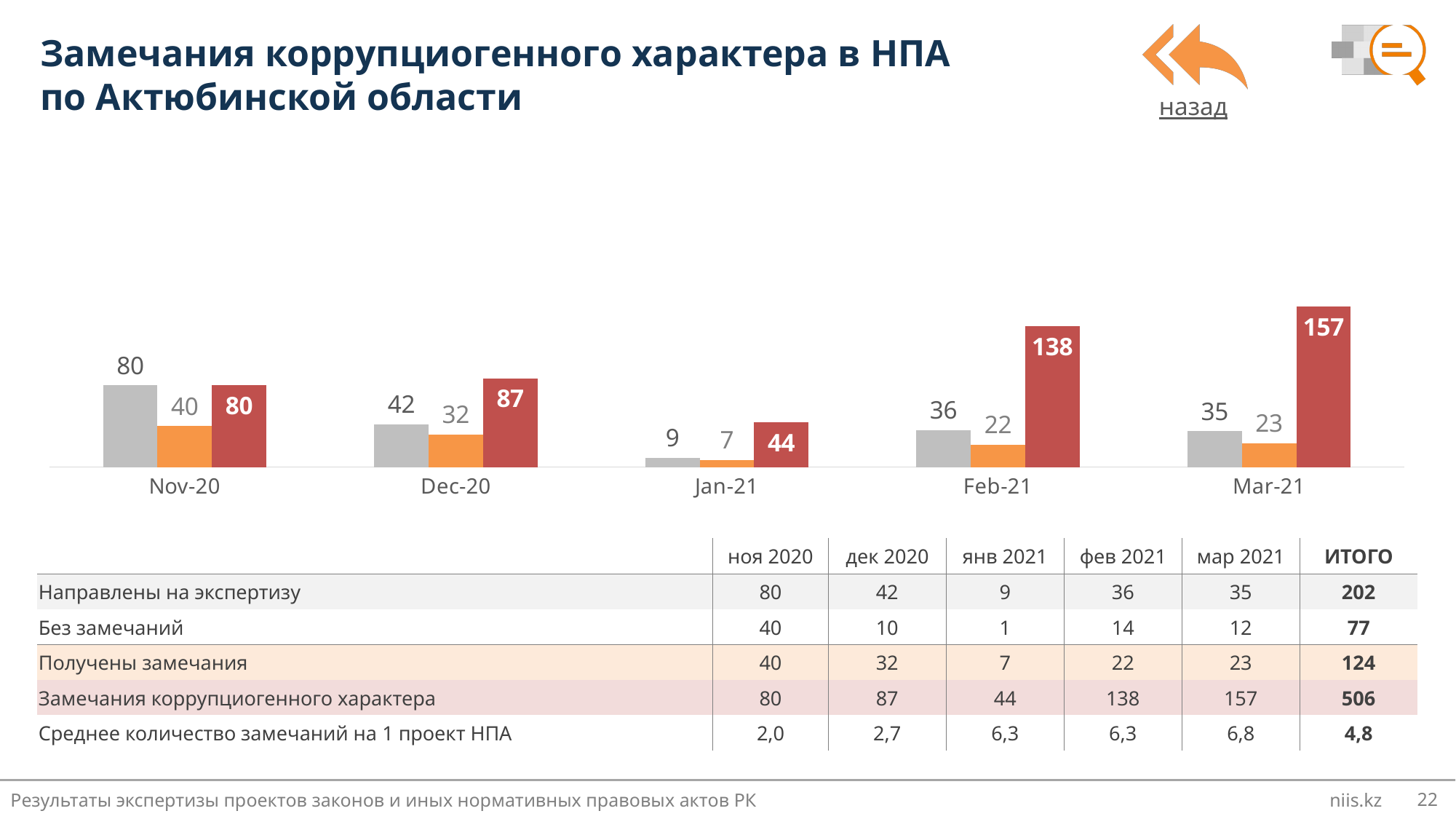
What kind of chart is shown on the slide? bar chart What is the value of the gray bar for Dec-20? 42 What is the difference between the red bar values for Mar-21 and Feb-21? 19 In which month is the red bar the highest? Mar-21 What is the difference between the gray bar and the orange bar for Feb-21? 14 What is the value of the orange bar for Mar-21? 23 How many months (categories) are shown on the x axis of the chart? 5 In which month is the gray bar the lowest? Jan-21 Does the red bar rise or fall from Jan-21 to Mar-21? rise What is the value of the red bar for Feb-21? 138 Which is larger for Nov-20: the gray bar or the orange bar? the gray bar How many bars are shown for each month in the chart? 3